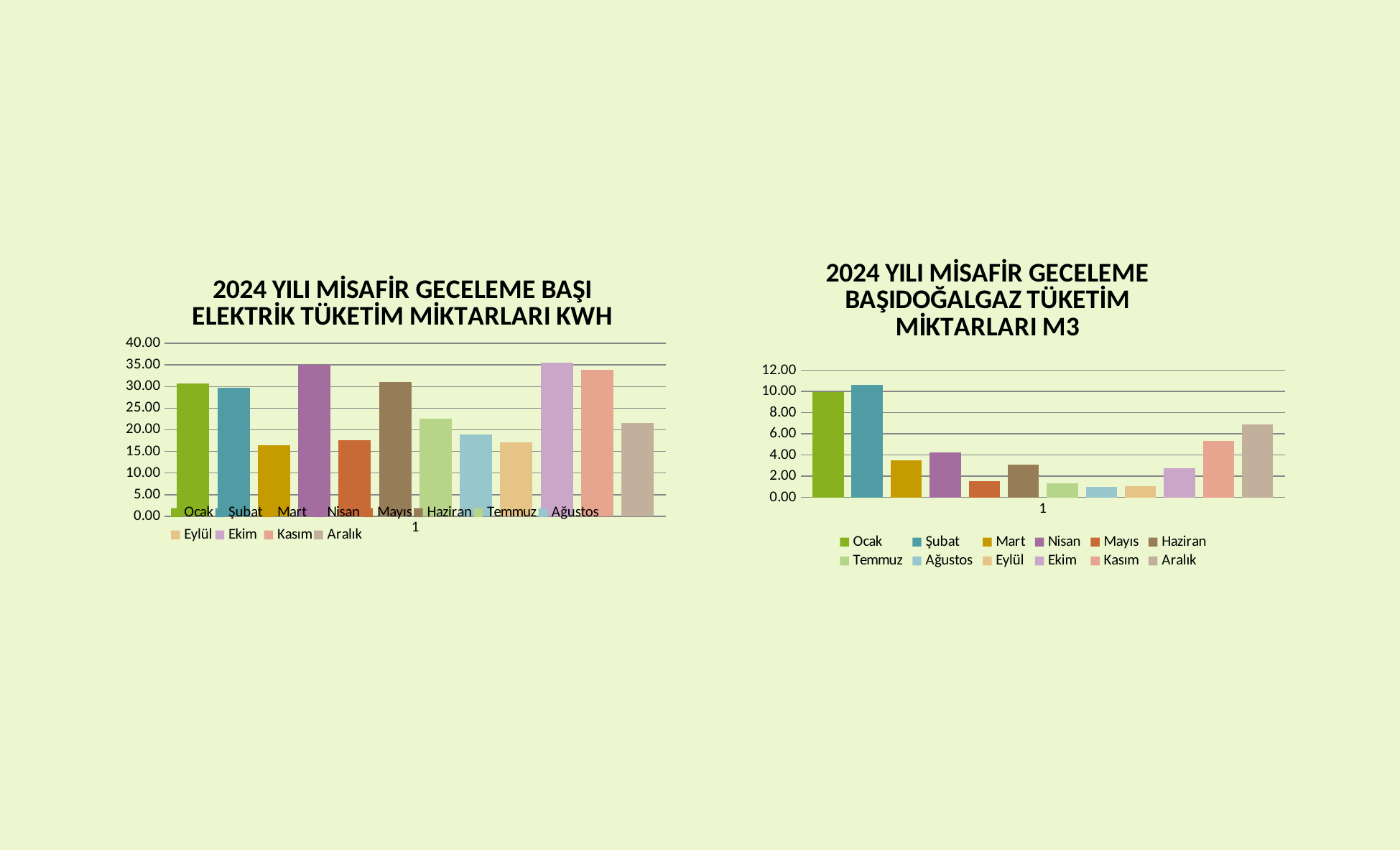
How many series does the legend of the left chart (electricity consumption, KWH) list? 12 In the right chart (natural gas consumption, M3), which is larger, the value for Kasım or the value for Ekim? Kasım In the right chart (natural gas consumption, M3), which month has the highest value? Şubat In the left chart (electricity consumption, KWH), is the value for Temmuz greater or less than 20? greater In the right chart (natural gas consumption, M3), is the value for Mart greater or less than 4? less In the left chart (electricity consumption, KWH), which is larger, the value for Nisan or the value for Mart? Nisan In the right chart (natural gas consumption, M3), is the value for Aralık greater or less than 6? greater In the left chart (electricity consumption, KWH), which is larger, the value for Haziran or the value for Temmuz? Haziran How many series does the legend of the right chart (natural gas consumption, M3) list? 12 What kind of chart is the left chart, '2024 YILI MİSAFİR GECELEME BAŞI ELEKTRİK TÜKETİM MİKTARLARI KWH'? Bar chart